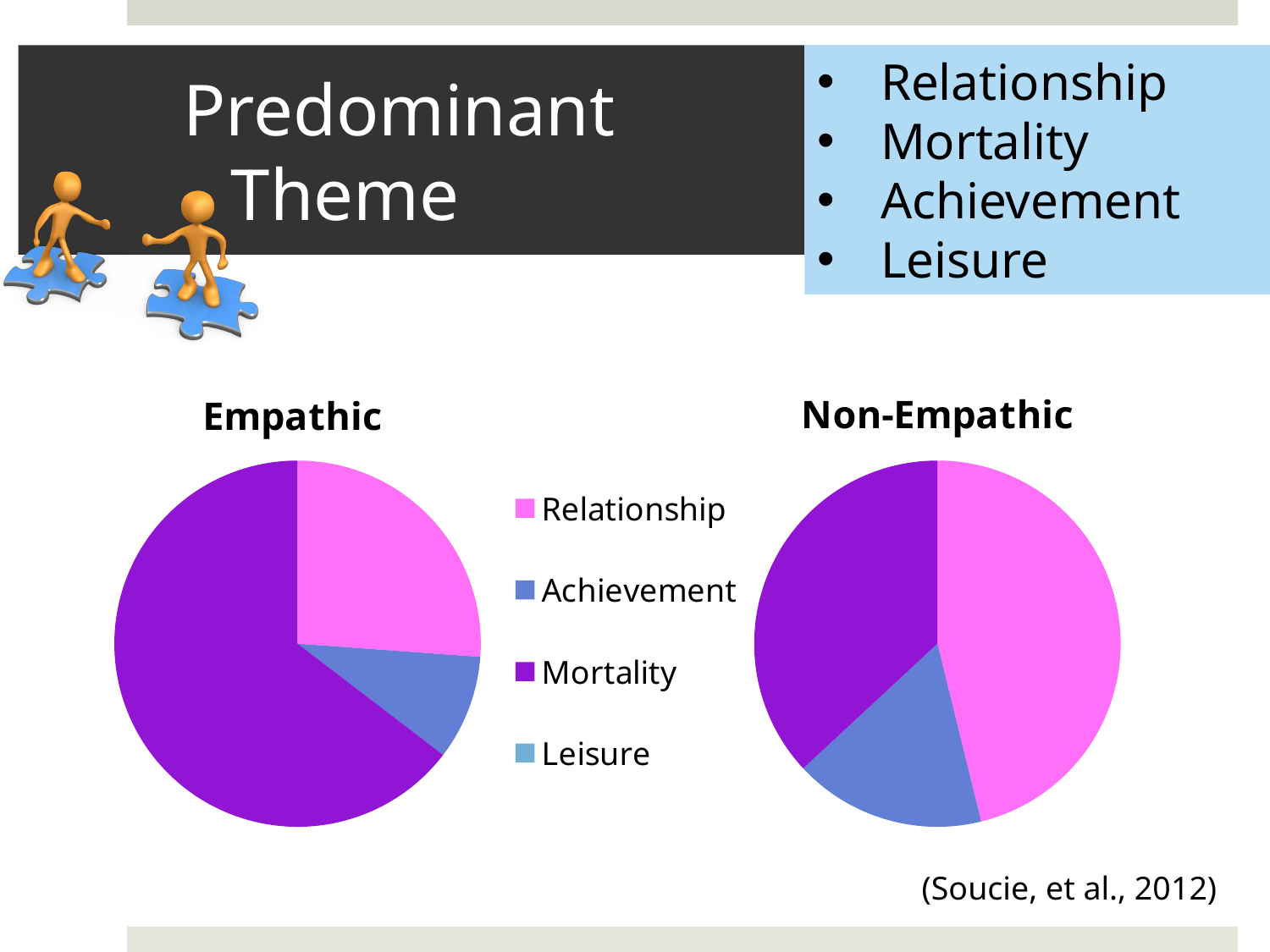
How many categories does the shared legend list for the pie charts? 4 In the Non-Empathic pie chart, which slice is larger: Mortality or Achievement? Mortality In the Non-Empathic pie chart, which of the visible slices is the smallest? Achievement What colour represents Mortality in the pie charts? Purple What kind of chart is the Empathic chart? Pie chart What is the title of the pie chart on the left of the slide? Empathic In the Empathic pie chart, which of the visible slices is the smallest? Achievement In the Non-Empathic pie chart, which category has the largest slice? Relationship In the Empathic pie chart, which category has the largest slice? Mortality In the Non-Empathic pie chart, which slice is larger: Relationship or Mortality? Relationship What kind of chart is the Non-Empathic chart? Pie chart In the Empathic pie chart, which slice is larger: Mortality or Relationship? Mortality